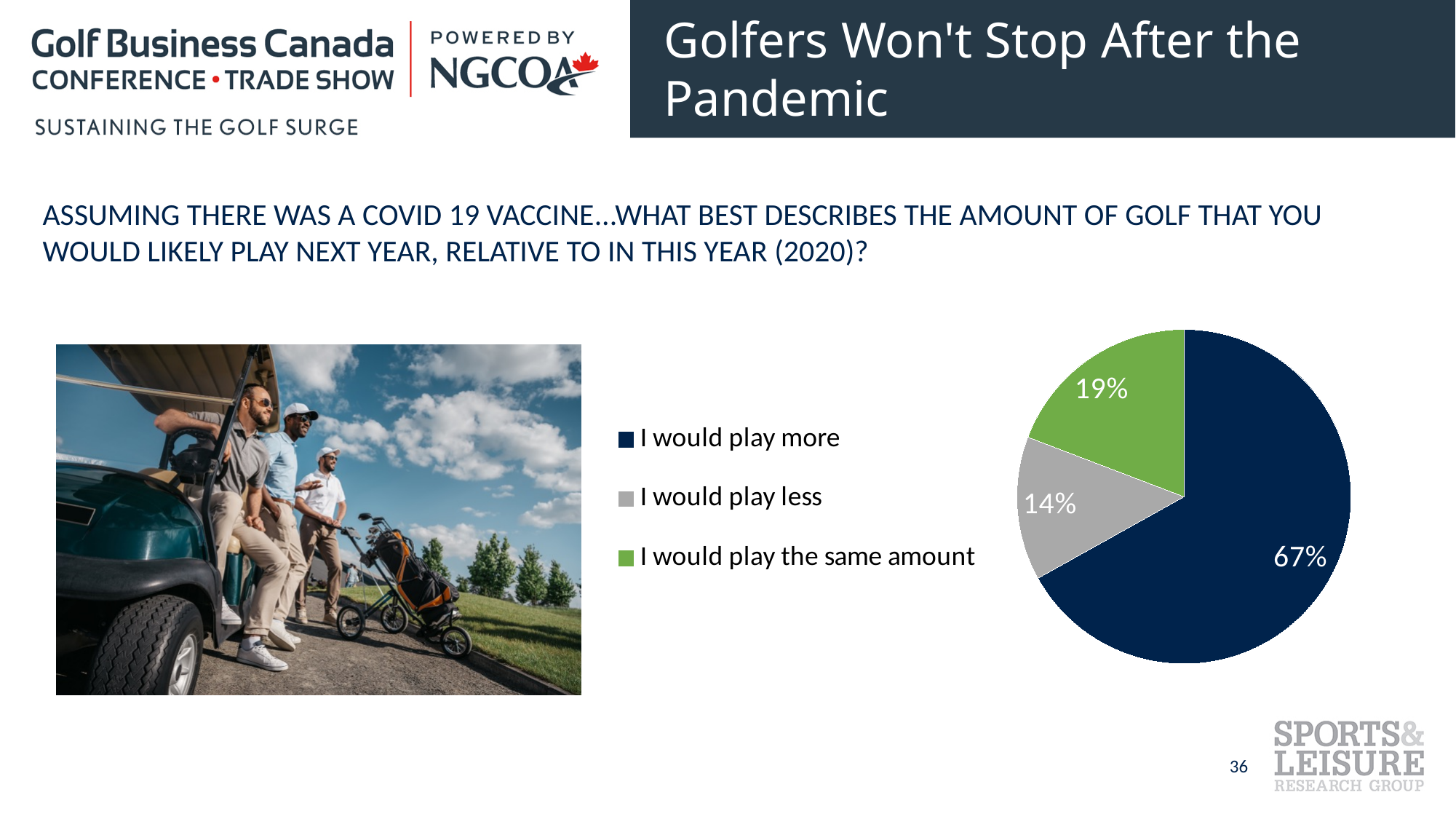
What is the difference in percentage points between "I would play more" and "I would play the same amount"? 48 What is the difference in percentage points between "I would play the same amount" and "I would play less"? 5 Which is larger: the share for "I would play less" or "I would play the same amount"? I would play the same amount What percentage of respondents said "I would play the same amount"? 19% How many slices does the pie chart have? 3 What percentage of respondents said "I would play more"? 67% Which response has the largest share of the pie? I would play more What percentage of respondents said "I would play less"? 14% Which response has the smallest share of the pie? I would play less What kind of chart is shown on the slide? Pie chart What colour is the slice for "I would play less"? Grey How many entries does the legend list? 3